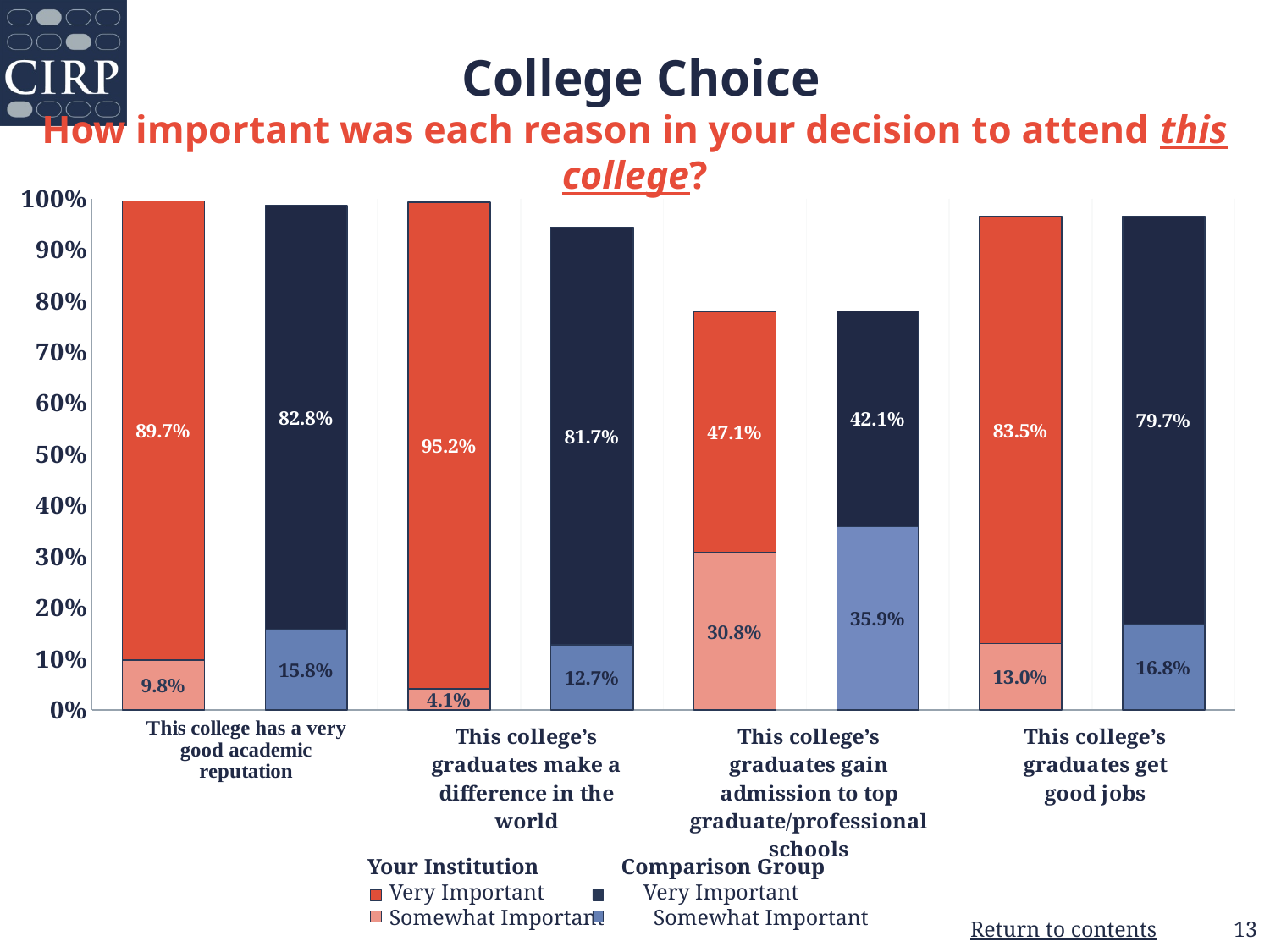
What percentage of the Comparison Group rated "This college's graduates get good jobs" as Somewhat Important? 16.8% Which reason has the lowest Very Important percentage for the Comparison Group? This college's graduates gain admission to top graduate/professional schools For "This college's graduates get good jobs", which is larger: the Your Institution Very Important percentage or the Comparison Group Very Important percentage? Your Institution What percentage of Your Institution students rated "This college has a very good academic reputation" as Very Important? 89.7% Which reason has the highest Very Important percentage for Your Institution? This college's graduates make a difference in the world What kind of chart is shown on the slide? Stacked bar chart What is the combined Very Important and Somewhat Important total for Your Institution on "This college's graduates gain admission to top graduate/professional schools"? 77.9% What is the combined Very Important and Somewhat Important total for the Comparison Group on "This college has a very good academic reputation"? 98.6% What is the difference between the Your Institution and Comparison Group Very Important percentages for "This college's graduates make a difference in the world"? 13.5% How many series does the legend list? 4 What percentage of Your Institution students rated "This college's graduates gain admission to top graduate/professional schools" as Somewhat Important? 30.8% How many reasons (categories) are shown on the x axis of the chart? 4